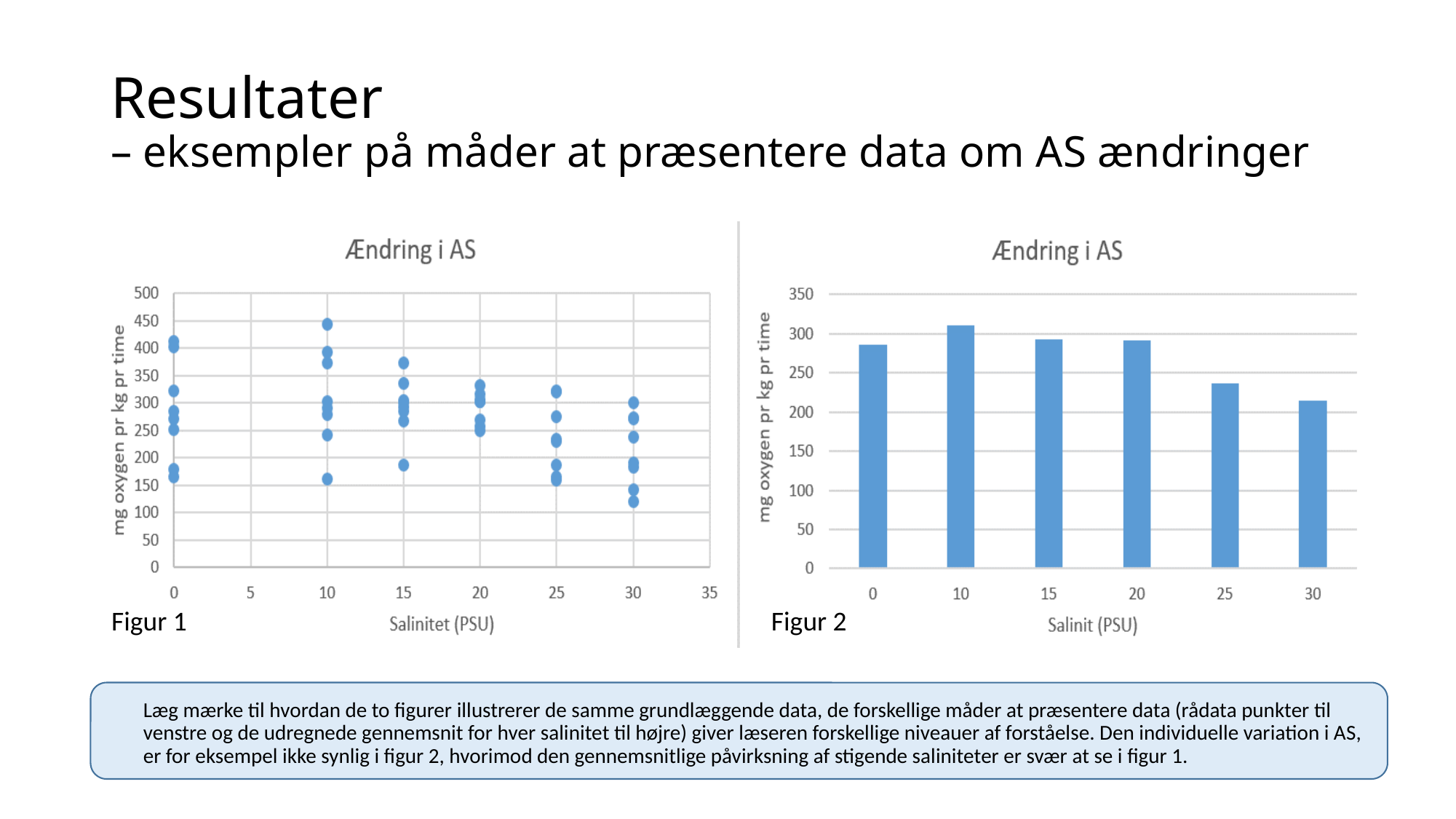
In Figur 2, is the value for salinity 10 greater or less than 300? greater What is the y-axis label of the chart in Figur 1? mg oxygen pr kg pr time In Figur 2, how many bars are plotted? 6 In Figur 2, is the value for salinity 30 greater or less than 250? less In Figur 2, which salinity has the lowest bar? 30 In Figur 2, which is larger, the bar for salinity 10 or the bar for salinity 30? salinity 10 What is the title of the chart in Figur 2? Ændring i AS What kind of chart is Figur 1? scatter chart In Figur 2, is the value for salinity 25 greater or less than 250? less What kind of chart is Figur 2? bar chart In Figur 2, which salinity has the highest bar? 10 In Figur 2, do the bar values generally rise or fall as salinity increases from 10 to 30? fall